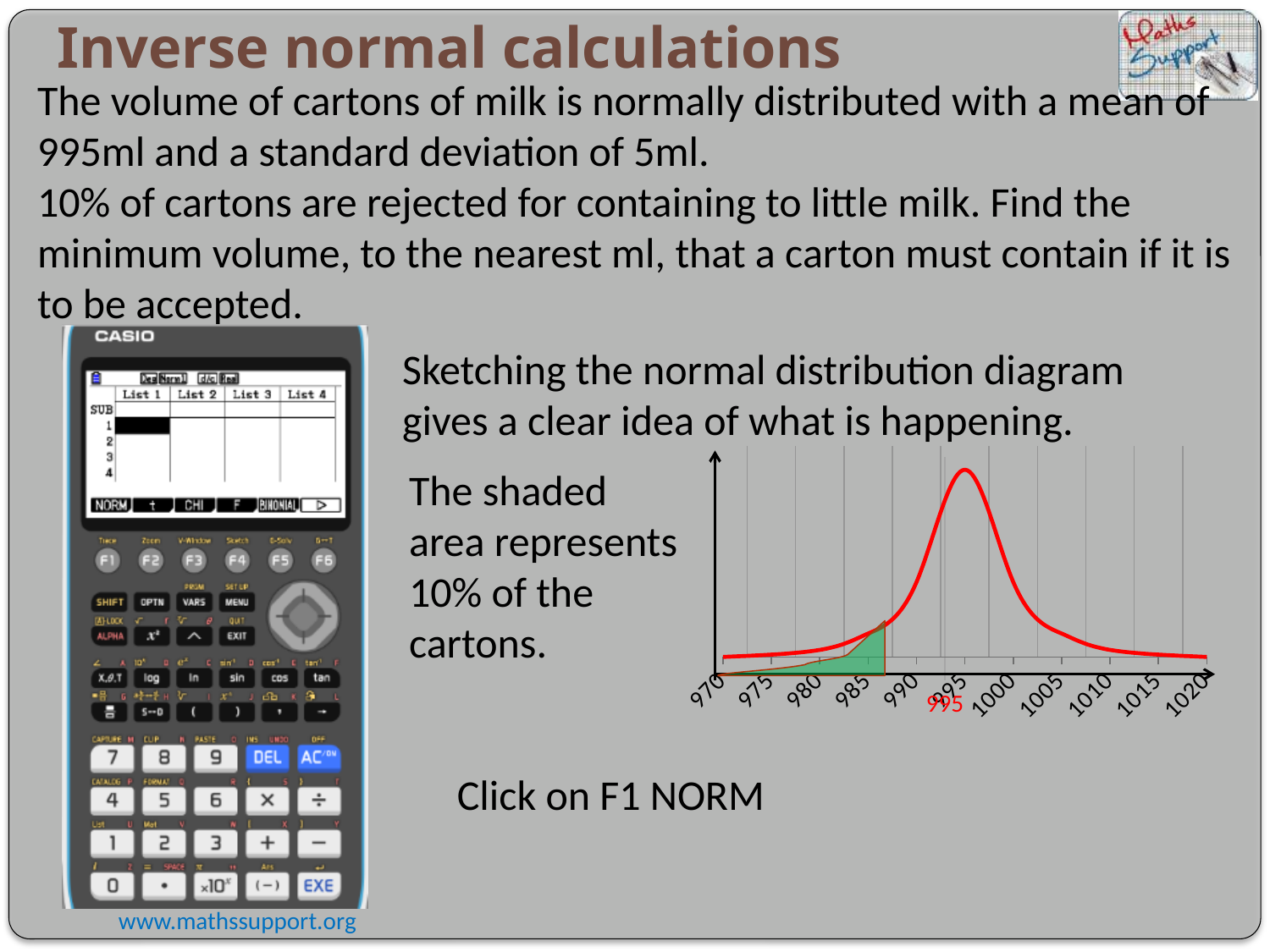
What is the step between consecutive tick labels on the x axis of the diagram? 5 What colour is the shaded area under the curve in the diagram? green What is the highest value labelled on the x axis of the diagram? 1020 What kind of chart is the diagram on the right of the slide? A normal distribution curve (line chart) Is the shaded region of the diagram to the left or to the right of the peak of the curve? left Which x-axis value is written in red beneath the diagram? 995 Does the red curve rise or fall as x increases from 970 to 995? rise How many labelled tick values are shown on the x axis of the normal distribution diagram? 11 What is the lowest value labelled on the x axis of the diagram? 970 According to the slide, what percentage of the cartons does the shaded area represent? 10% At what x-axis value does the red curve reach its highest point? 995 Does the red curve rise or fall as x increases from 995 to 1020? fall